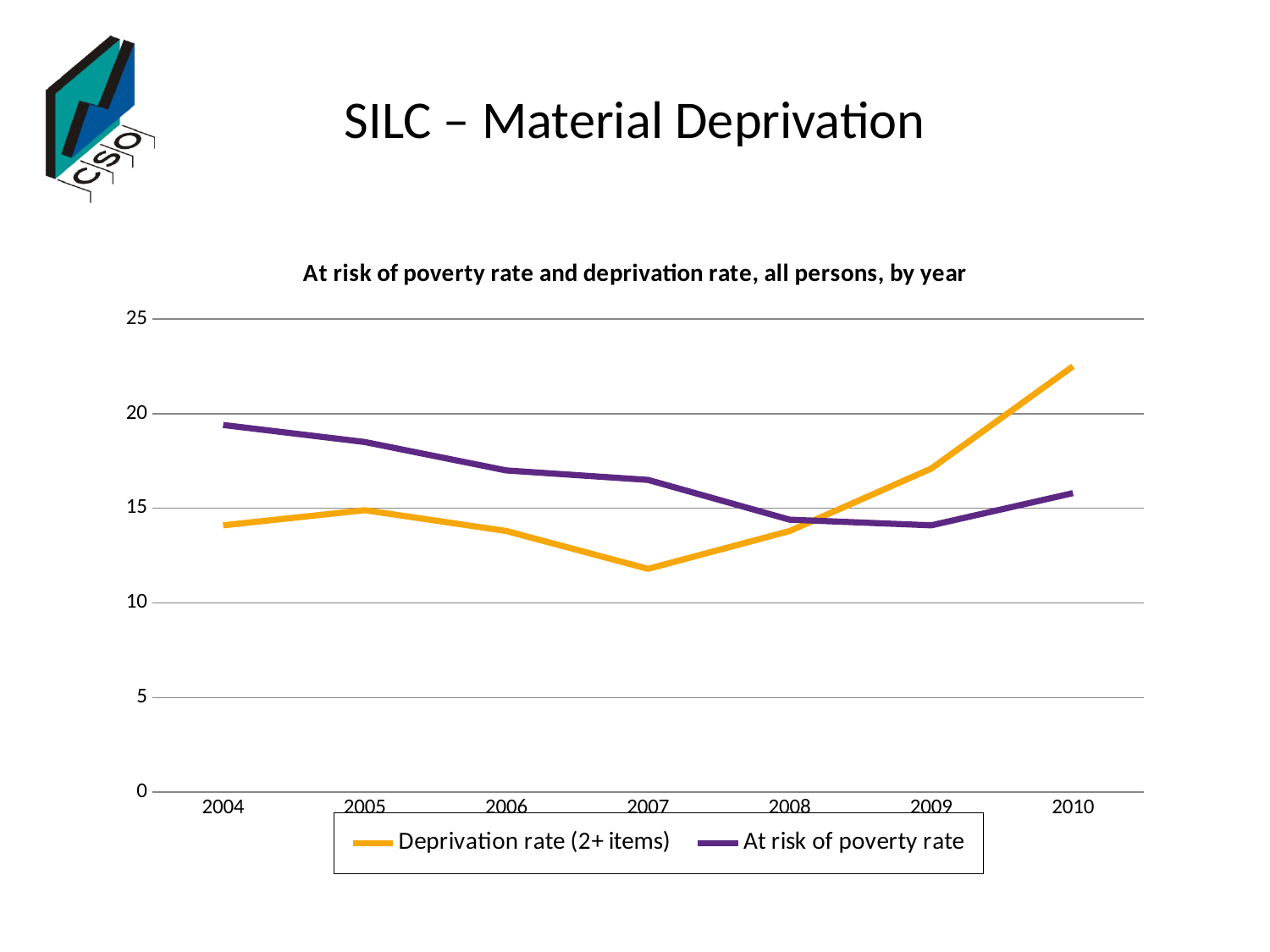
In which year is the At risk of poverty rate highest? 2004 Is the Deprivation rate (2+ items) in 2010 greater or less than 20? greater In which year is the Deprivation rate (2+ items) lowest? 2007 What kind of chart is shown on the slide? line chart Does the At risk of poverty rate rise or fall from 2004 to 2009? fall How many series does the legend list? 2 In which year is the Deprivation rate (2+ items) highest? 2010 Is the At risk of poverty rate in 2009 greater or less than 15? less Which series has the larger value in 2004, Deprivation rate (2+ items) or At risk of poverty rate? At risk of poverty rate How many years are plotted along the x axis? 7 What is the title of the chart? At risk of poverty rate and deprivation rate, all persons, by year Which series has the larger value in 2010, Deprivation rate (2+ items) or At risk of poverty rate? Deprivation rate (2+ items)